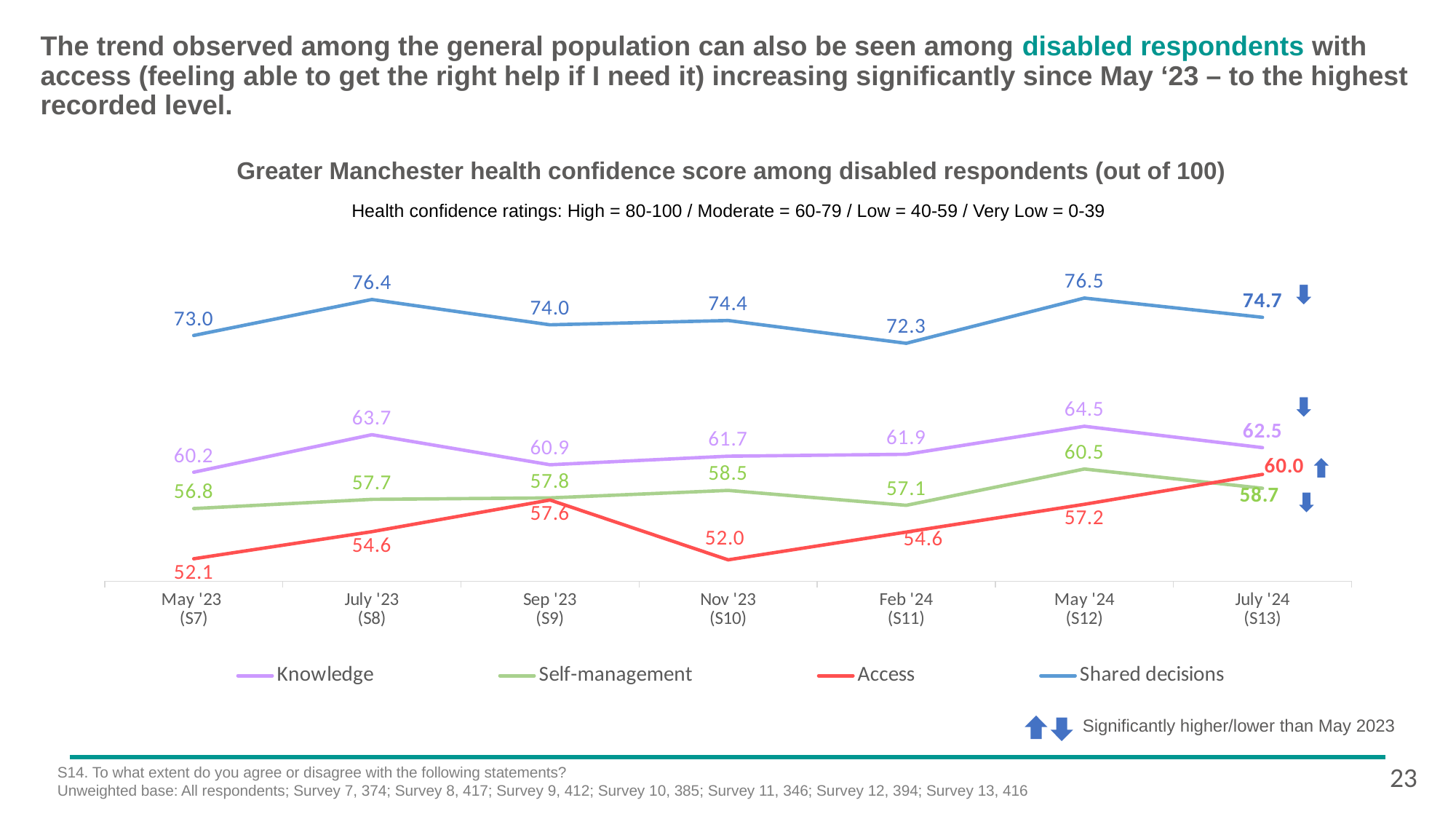
What is the difference between the Access score in July '24 (S13) and in May '23 (S7)? 7.9 What is the Shared decisions score in Feb '24 (S11)? 72.3 What type of chart is shown on the slide? Line chart Which is larger in July '24 (S13): the Access score or the Self-management score? Access How many series does the legend list? 4 What is the Access score in July '24 (S13)? 60.0 At which time point is the Shared decisions score highest? May '24 (S12) Does the Access score rise or fall between Feb '24 (S11) and July '24 (S13)? Rise At which time point is the Access score lowest? Nov '23 (S10) How many survey time points are plotted along the x axis? 7 What is the Knowledge score in May '24 (S12)? 64.5 Which series is drawn in red? Access